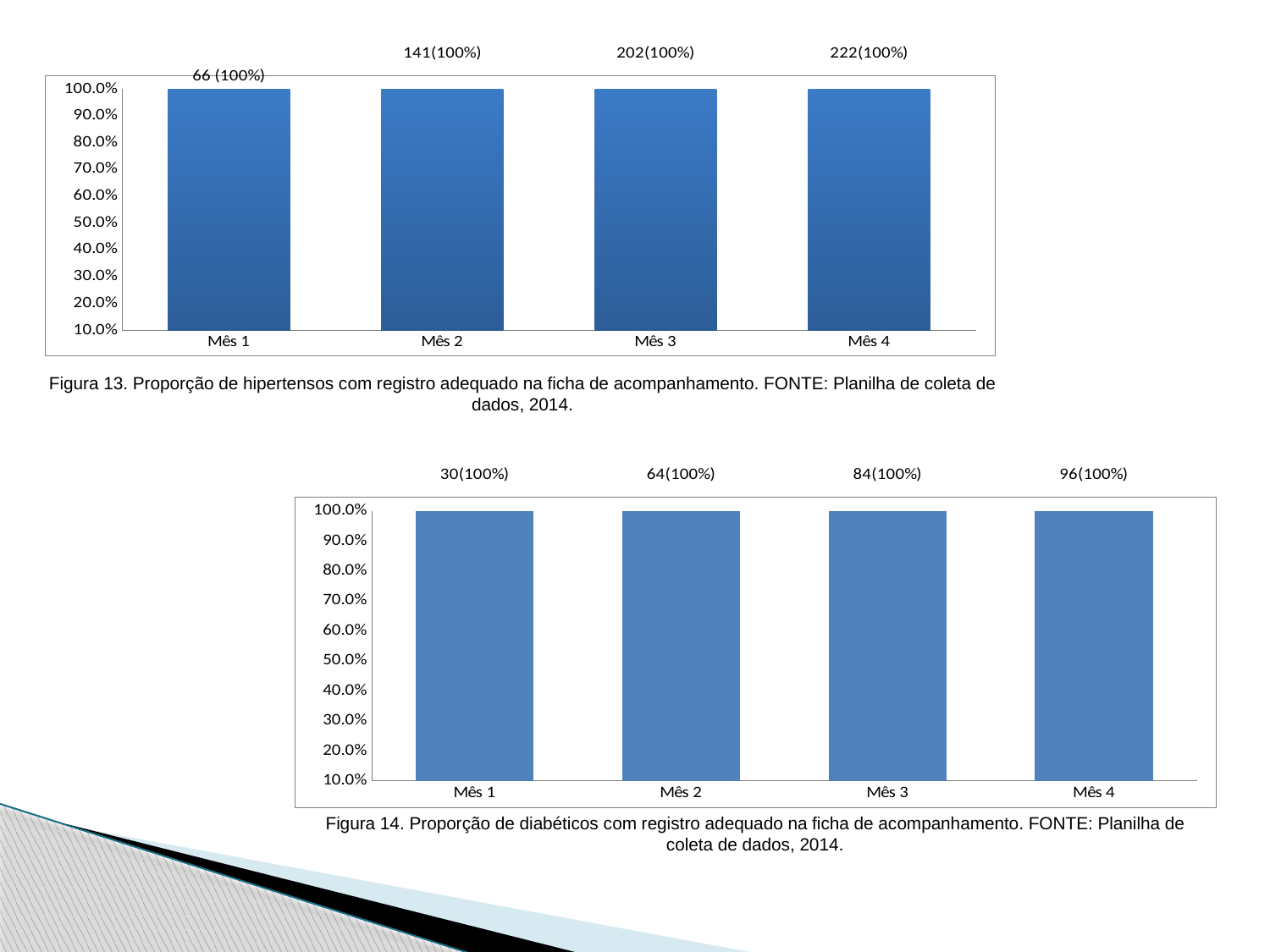
In the top chart (Figura 13), is the value for Mês 3 greater or less than 90.0%? greater In the bottom chart (Figura 14, diabéticos), what is the data label shown above the bar for Mês 4? 96(100%) In the top chart (Figura 13, hipertensos), what is the data label shown above the bar for Mês 4? 222(100%) What is the lowest value shown on the vertical axis of the bottom chart (Figura 14)? 10.0% In the bottom chart (Figura 14, diabéticos), what is the data label shown above the bar for Mês 3? 84(100%) In the top chart (Figura 13, hipertensos), what is the data label shown above the bar for Mês 1? 66 (100%) In the bottom chart (Figura 14), do the percentage values rise, fall, or stay the same from Mês 1 to Mês 4? Stay the same In the bottom chart (Figura 14, diabéticos), what is the data label shown above the bar for Mês 1? 30(100%) How many bars (months) are plotted in the bottom chart (Figura 14)? 4 How many bars (months) are plotted in the top chart (Figura 13)? 4 What kind of chart is the top chart (Figura 13)? Bar chart In the top chart (Figura 13, hipertensos), what is the data label shown above the bar for Mês 2? 141(100%)